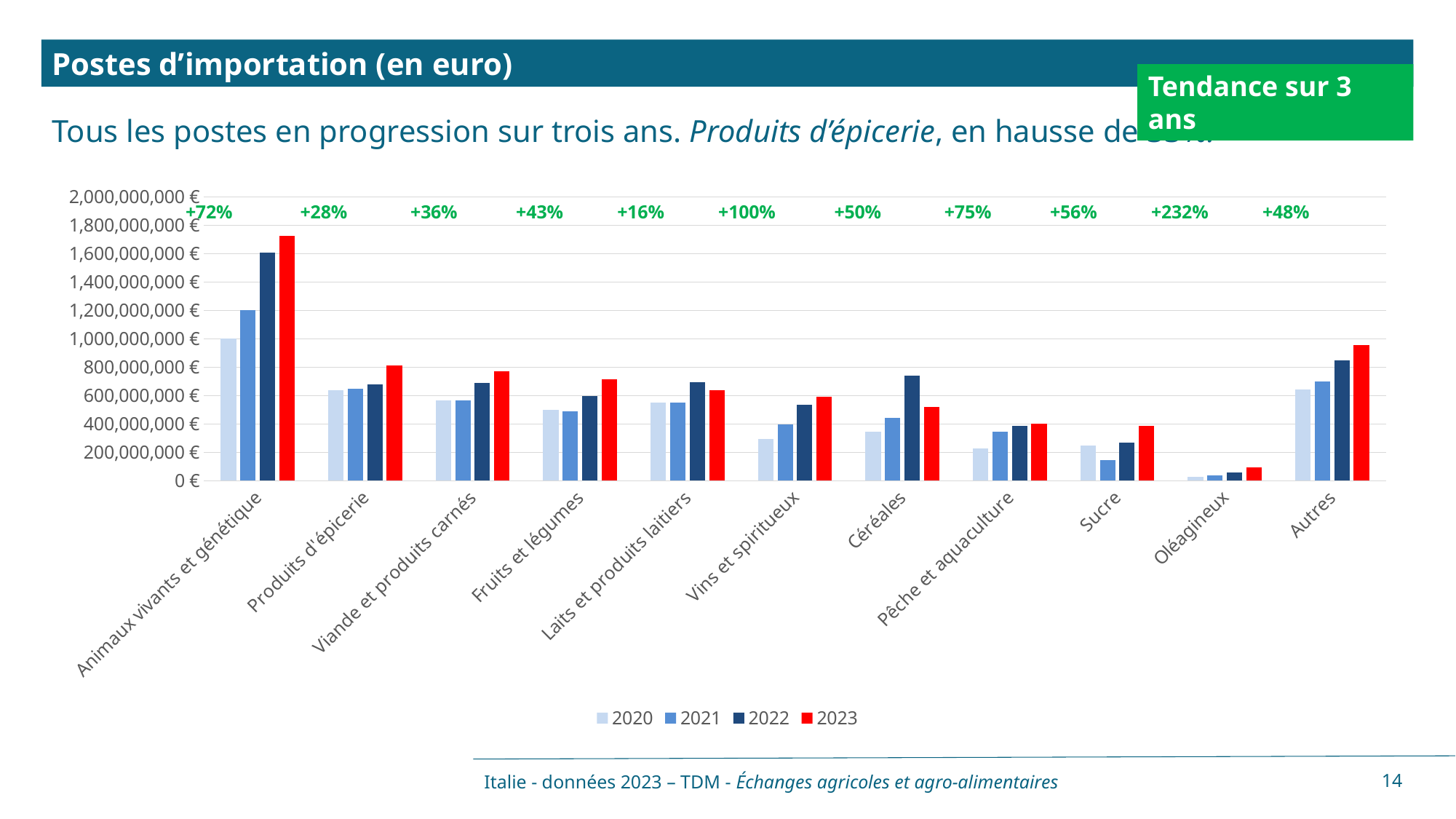
Which category has the highest printed three-year trend percentage? Sucre For Animaux vivants et génétique, do the values rise or fall from 2020 to 2023? rise How many import categories are shown on the x axis? 11 What three-year trend percentage is printed above the Vins et spiritueux group? +100% Which category has the lowest 2023 value? Oléagineux For Céréales, which is larger: the 2022 value or the 2023 value? 2022 Which category has the lowest printed three-year trend percentage? Laits et produits laitiers Which category has the highest 2023 value? Animaux vivants et génétique What three-year trend percentage is printed above the Sucre group? +232% How many series does the legend list? 4 Is the 2023 value for Produits d'épicerie greater or less than 600,000,000 €? greater What kind of chart is shown on the slide? Bar chart